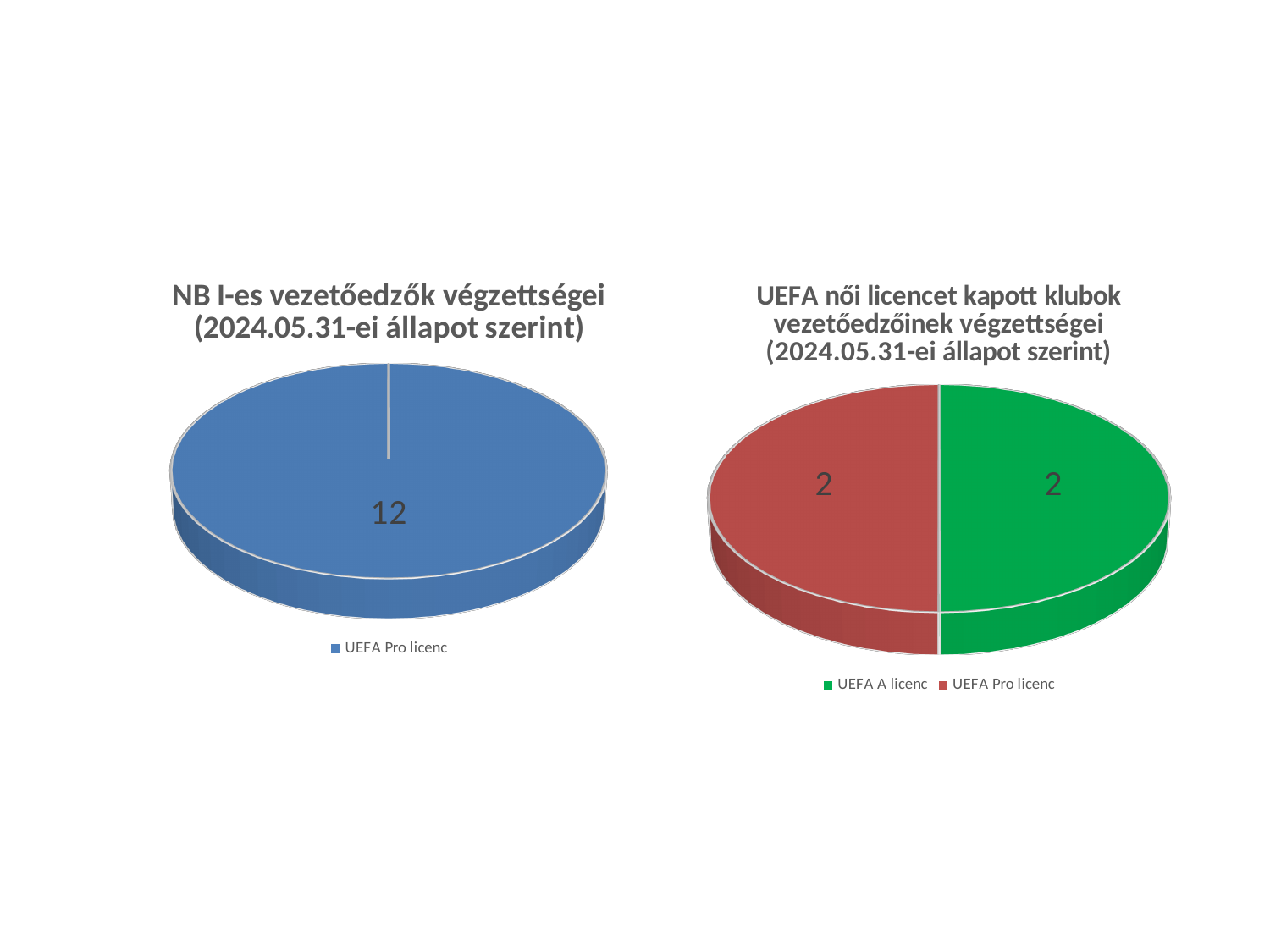
In the left chart (NB I-es vezetőedzők végzettségei), what share of the pie does UEFA Pro licenc take? 100% In the right chart (UEFA női licencet kapott klubok vezetőedzőinek végzettségei), what is the value for UEFA A licenc? 2 In the right chart (UEFA női licencet kapott klubok vezetőedzőinek végzettségei), which colour represents UEFA A licenc? green What kind of chart is the left chart (NB I-es vezetőedzők végzettségei)? pie chart How many categories does the legend of the left chart (NB I-es vezetőedzők végzettségei) list? 1 In the right chart (UEFA női licencet kapott klubok vezetőedzőinek végzettségei), what is the total of all slices? 4 How many slices does the right chart (UEFA női licencet kapott klubok vezetőedzőinek végzettségei) have? 2 In the left chart (NB I-es vezetőedzők végzettségei), what is the value for UEFA Pro licenc? 12 In the right chart (UEFA női licencet kapott klubok vezetőedzőinek végzettségei), what share of the pie does UEFA A licenc take? 50% What is the title of the left chart? NB I-es vezetőedzők végzettségei (2024.05.31-ei állapot szerint) In the right chart (UEFA női licencet kapott klubok vezetőedzőinek végzettségei), what is the difference between the UEFA A licenc and UEFA Pro licenc values? 0 In the right chart (UEFA női licencet kapott klubok vezetőedzőinek végzettségei), what is the value for UEFA Pro licenc? 2